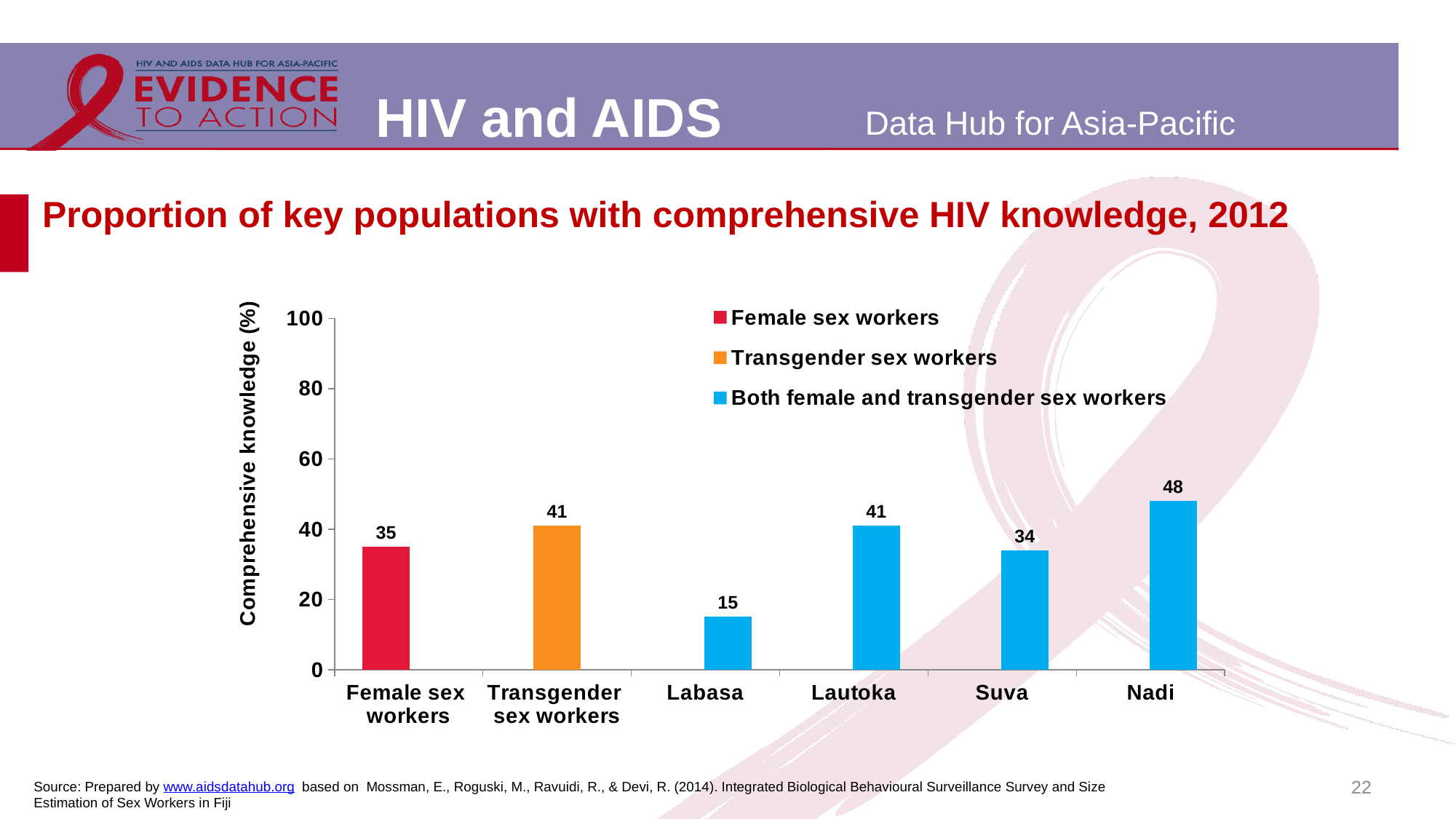
How many categories are shown on the x axis? 6 What is the value for Female sex workers? 35 What is the difference between the values for Nadi and Suva? 14 Which category has the highest value? Nadi What is the value for Transgender sex workers? 41 What is the value for Labasa? 15 What kind of chart is shown on the slide? bar chart Is the value for Labasa greater or less than 20? less What is the value for Nadi? 48 How many series does the legend list? 3 Which category has the lowest value? Labasa Which is larger, the value for Lautoka or the value for Suva? Lautoka